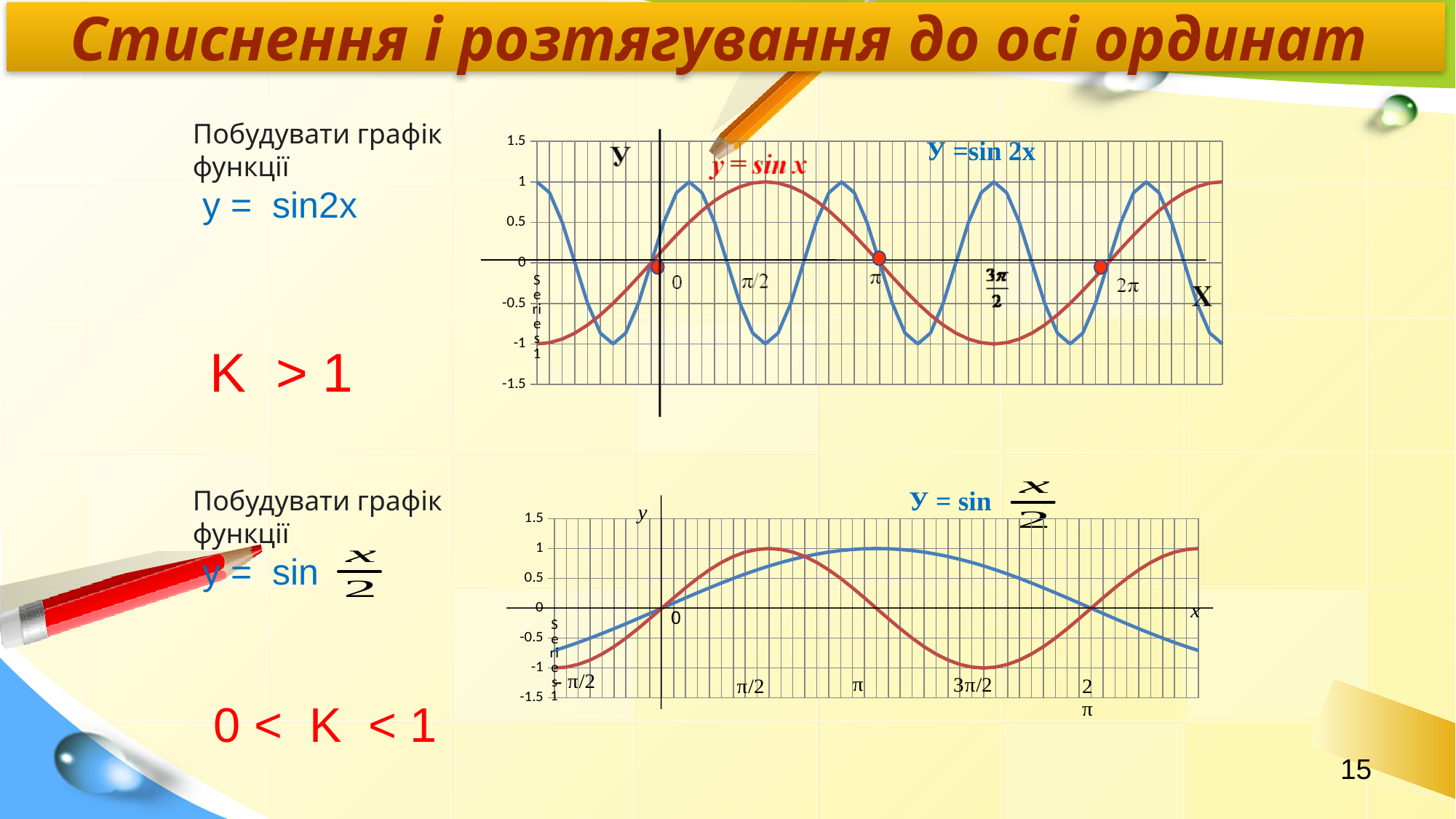
In the bottom chart, what is the value of y = sin x/2 at x = π? 1 In the top chart, what is the value of y = sin x at x = 3π/2? -1 In the bottom chart, what is the value of y = sin x at x = π? 0 In the top chart, how many curves are plotted? 2 In the bottom chart, at x = π/2, which curve is higher, y = sin x or y = sin x/2? y = sin x In the top chart, what colour is the curve y = sin x? red In the top chart, what is the value of y = sin x at x = π/2? 1 In the top chart, how many red dots are marked on the x axis? 3 In the bottom chart, what is the highest value shown on the y axis? 1.5 In the top chart, what is the value of y = sin 2x at x = π/2? 0 In the top chart, which curve completes more oscillations between 0 and 2π, y = sin x or y = sin 2x? y = sin 2x What kind of chart is the top chart on the slide? line chart